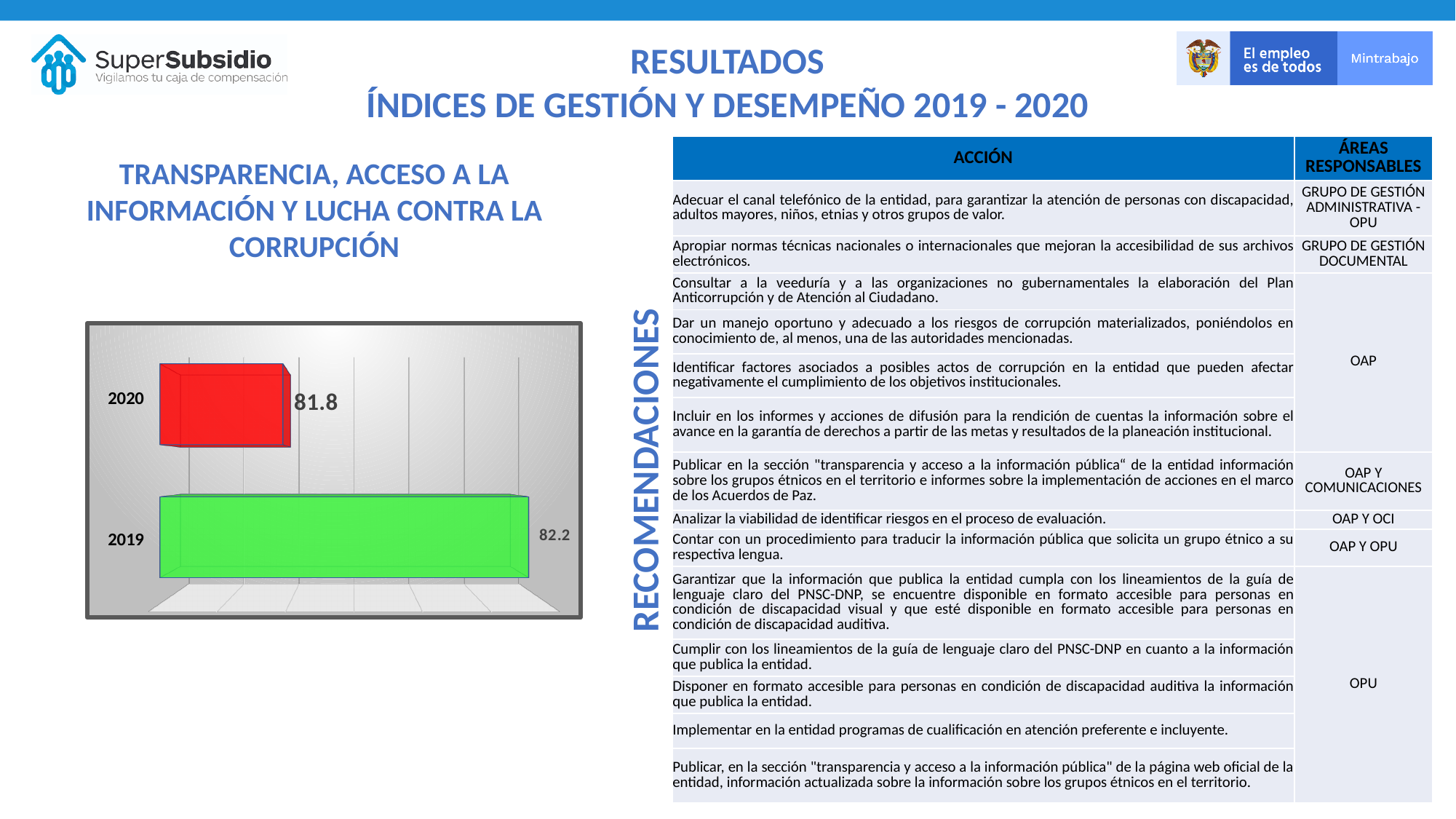
How many years are shown in the bar chart? 2 What colour is the bar for 2020? red What kind of chart is shown on the left of the slide? bar chart What is the value for 2020 in the bar chart? 81.8 What is the difference between the 2019 and 2020 values in the bar chart? 0.4 What is the value for 2019 in the bar chart? 82.2 Is the value for 2020 larger or smaller than the value for 2019? smaller Which year has the higher value in the bar chart? 2019 Did the value rise or fall from 2019 to 2020? fall What colour is the bar for 2019? green Which year has the lower value in the bar chart? 2020